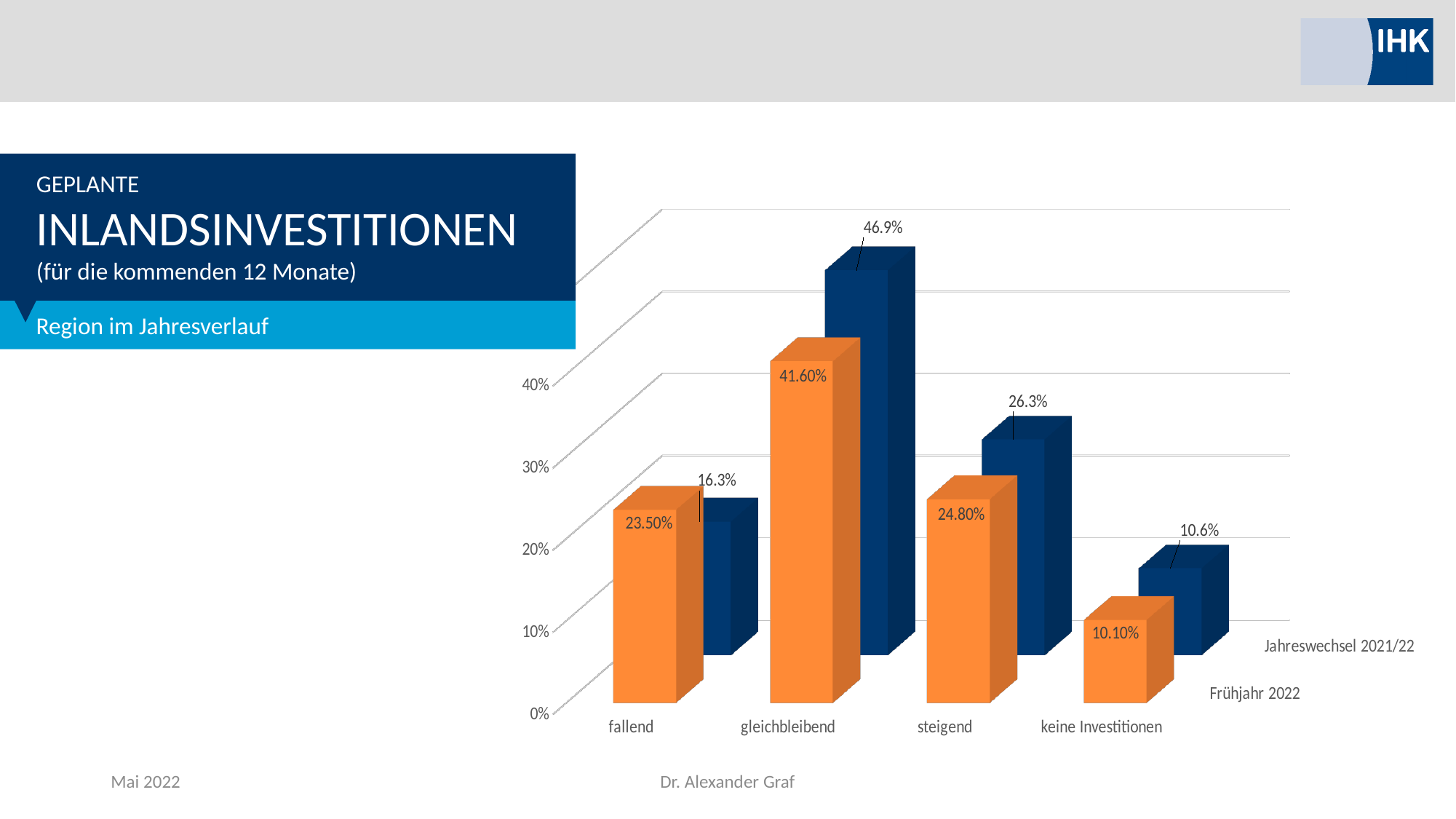
What is the value for "keine Investitionen" in the Frühjahr 2022 series? 10.10% What is the difference between the Jahreswechsel 2021/22 and Frühjahr 2022 values for "gleichbleibend"? 5.3 percentage points How many series does the chart show? 2 Which category has the lowest value in the Frühjahr 2022 series? keine Investitionen What is the value for "steigend" in the Jahreswechsel 2021/22 series? 26.3% Which category has the highest value in the Jahreswechsel 2021/22 series? gleichbleibend What is the difference between the Frühjahr 2022 and Jahreswechsel 2021/22 values for "fallend"? 7.2 percentage points For "fallend", which series has the larger value: Frühjahr 2022 or Jahreswechsel 2021/22? Frühjahr 2022 What kind of chart is shown on the slide? Bar chart How many categories are shown on the x axis of the chart? 4 What is the value for "fallend" in the Jahreswechsel 2021/22 series? 16.3% What is the value for "gleichbleibend" in the Frühjahr 2022 series? 41.60%